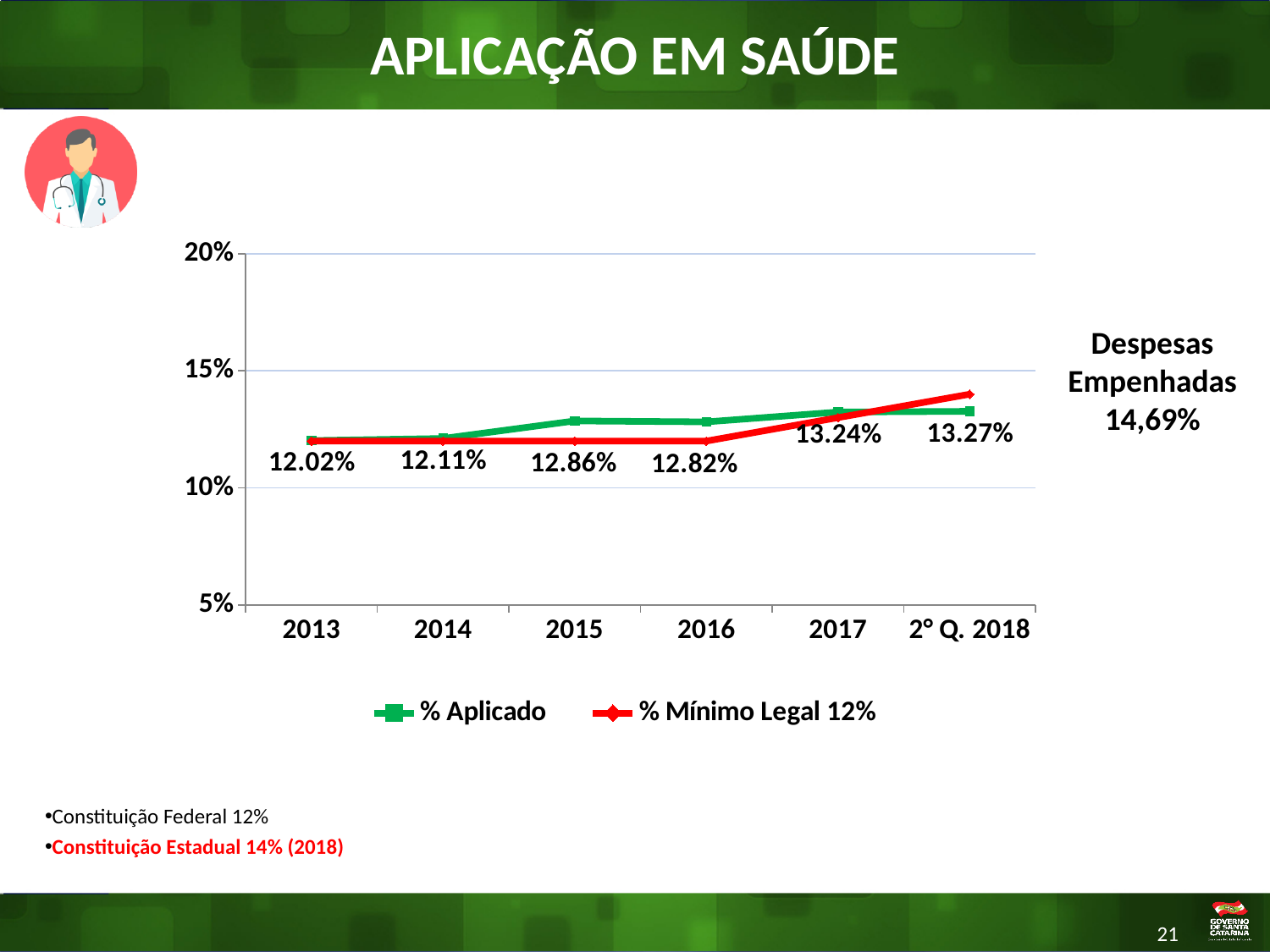
In which period is the % Aplicado value highest? 2° Q. 2018 In which year is the % Aplicado value lowest? 2013 Is the % Mínimo Legal 12% value for 2° Q. 2018 greater or less than 15%? less How many periods are shown on the x axis? 6 What kind of chart is shown on the slide? line chart Does the % Aplicado series generally rise or fall from 2013 to 2° Q. 2018? rise What is the % Aplicado value for 2013? 12.02% How many series does the legend list? 2 What is the % Aplicado value for 2017? 13.24% Which year has the larger % Aplicado value, 2015 or 2016? 2015 What is the % Aplicado value for 2° Q. 2018? 13.27% What is the difference between the % Aplicado values for 2015 and 2014? 0.75%